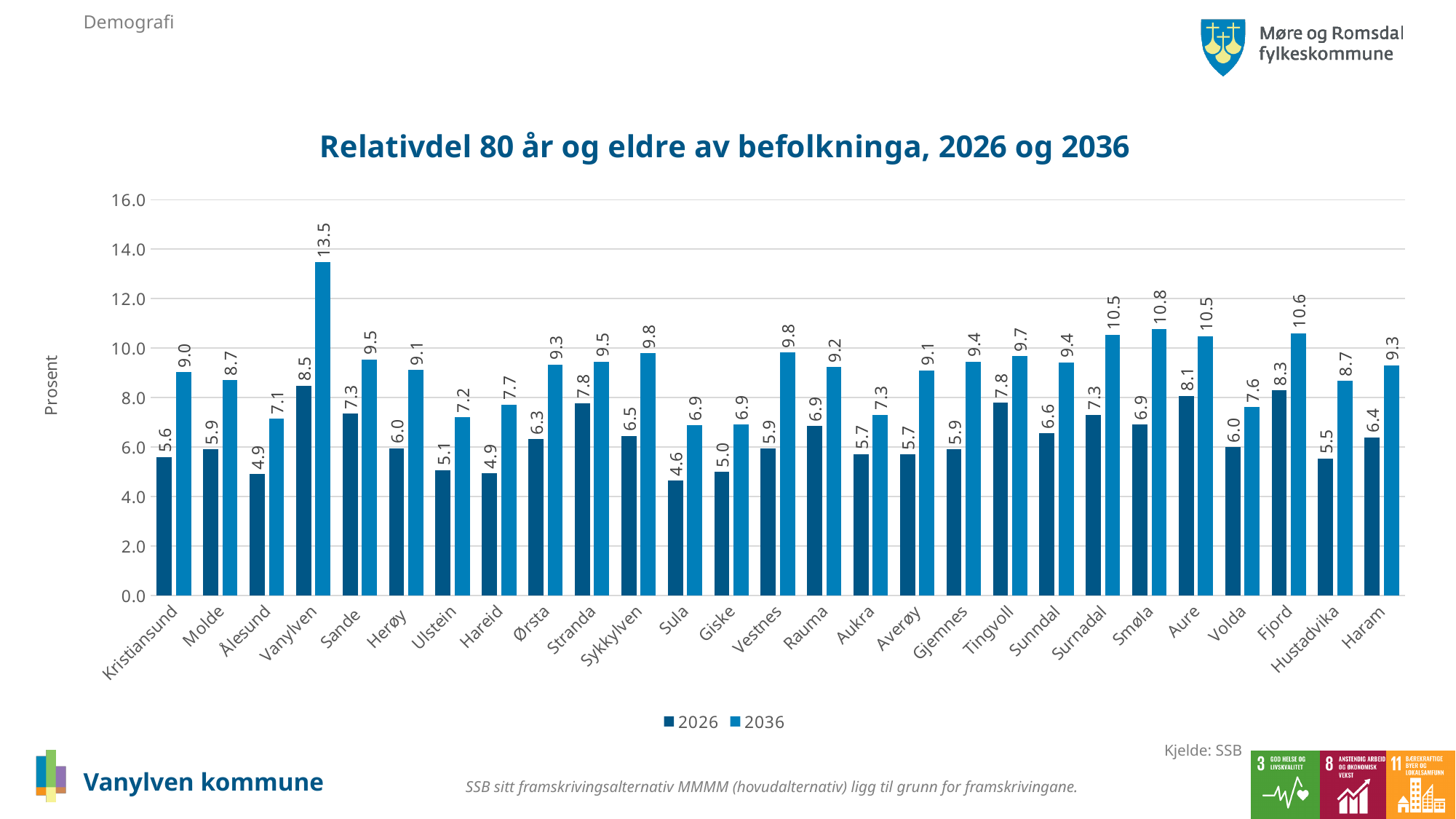
How many series does the legend list? 2 Which municipality has the lowest value in 2026? Sula What is the value for Smøla in 2036? 10.8 Which is larger, the 2036 value for Fjord or the 2036 value for Volda? Fjord What is the value for Sula in 2026? 4.6 What is the value for Vanylven in 2036? 13.5 What is the difference between the 2036 and 2026 values for Vanylven? 5.0 Which municipality has the highest value in 2036? Vanylven Is the 2036 value for Surnadal greater or less than 10.0? greater What is the difference between the 2036 and 2026 values for Smøla? 3.9 How many municipalities are shown on the x axis? 27 What type of chart is shown? Bar chart